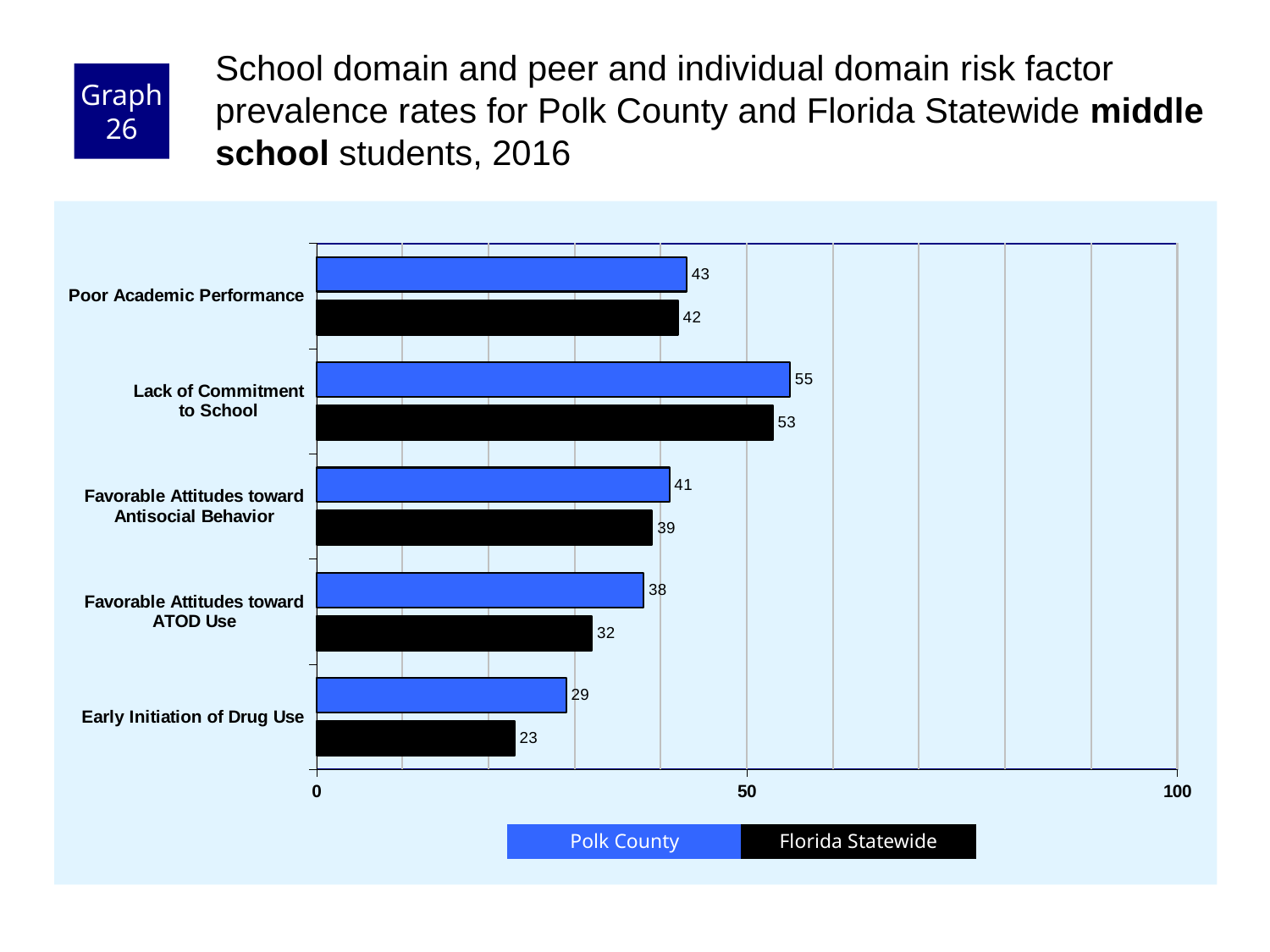
What is the Florida Statewide value for Early Initiation of Drug Use? 23 Which risk factor has the lowest Florida Statewide value? Early Initiation of Drug Use Which is larger for Early Initiation of Drug Use: the Polk County value or the Florida Statewide value? Polk County What kind of chart is shown on the slide? bar chart How many risk factor categories are shown on the chart? 5 Which colour represents Florida Statewide in the chart? black What is the Polk County value for Lack of Commitment to School? 55 What is the difference between the Polk County and Florida Statewide values for Favorable Attitudes toward ATOD Use? 6 Is the Polk County value for Poor Academic Performance greater or less than 50? less Which risk factor has the highest Polk County value? Lack of Commitment to School What is the Florida Statewide value for Favorable Attitudes toward ATOD Use? 32 How many series does the legend list? 2